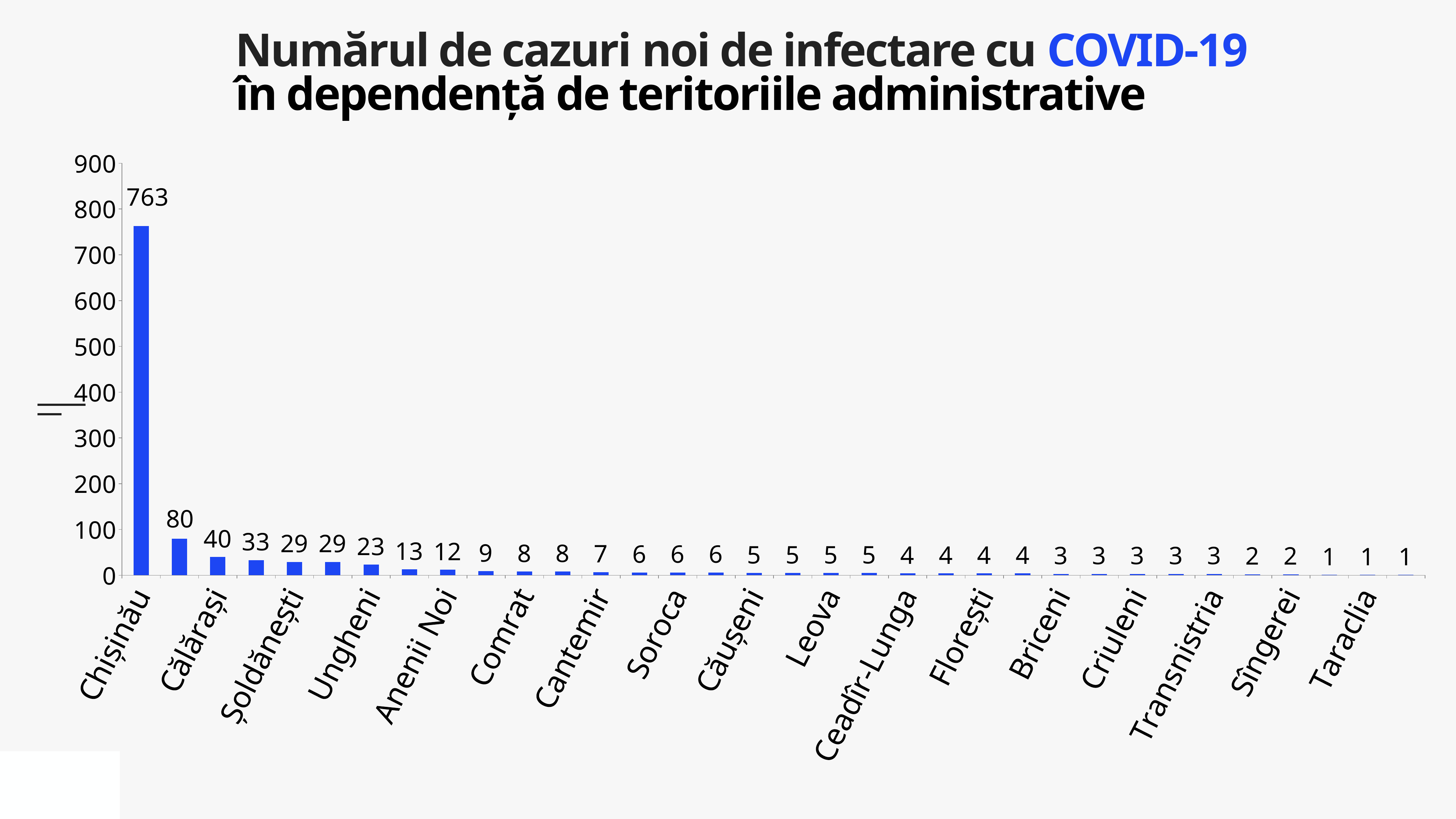
How many bars have a value greater than 100? 1 What is the highest tick value on the vertical axis? 900 Which category has the highest number of new cases? Chișinău How many bars are plotted in the chart? 34 Is the value for Chișinău greater or less than 700? greater What is the difference between the tallest bar (763) and the second-tallest bar (80)? 683 What is the value of the second-tallest bar? 80 What kind of chart is shown? bar chart What is the smallest value shown on any bar? 1 What is the value for Chișinău? 763 What colour are the bars? blue Do the values rise or fall from left to right along the x axis? fall